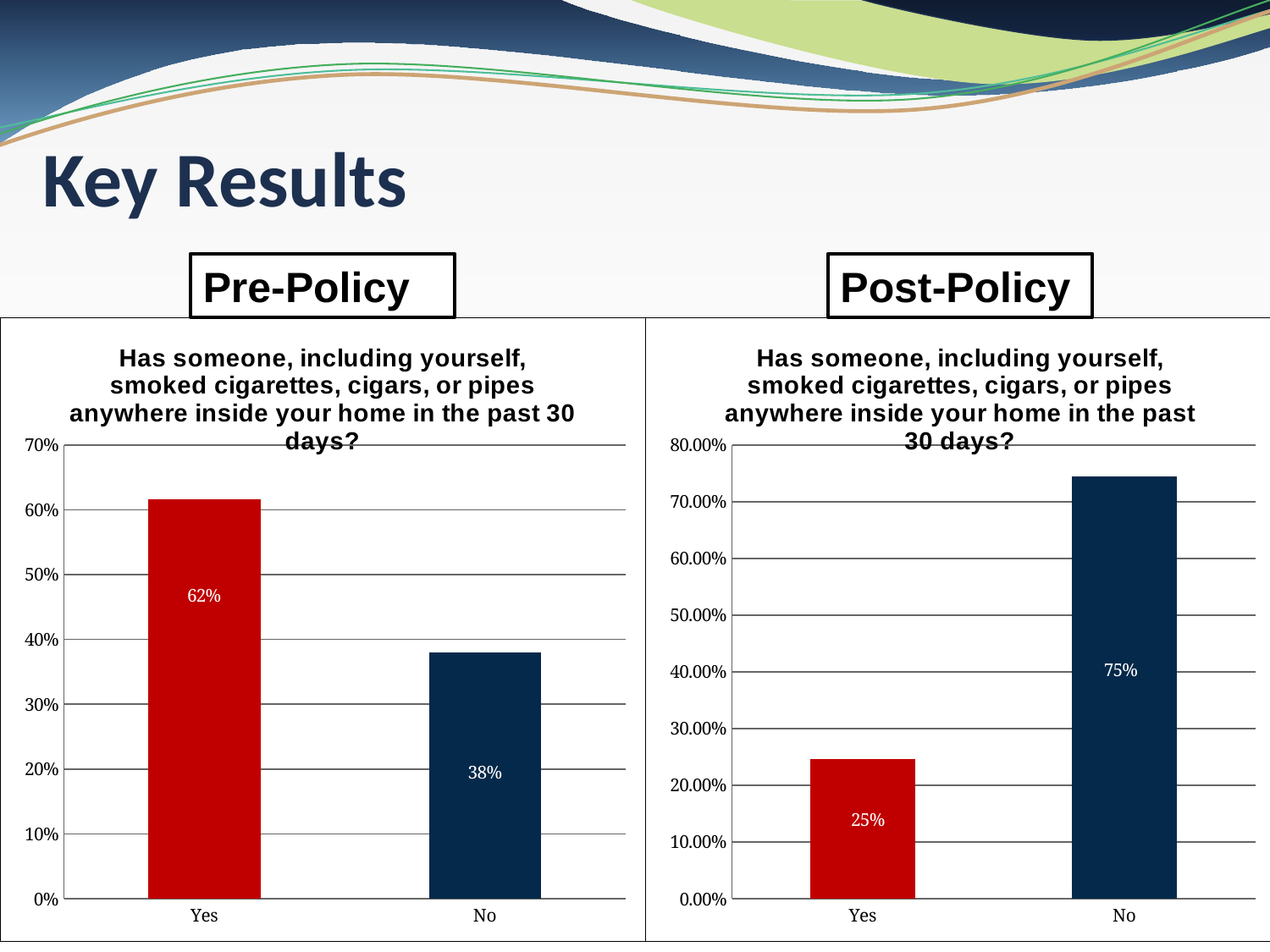
In the Post-Policy chart, which is larger, Yes or No? No In the Pre-Policy chart, is the value for No greater or less than 40%? less In the Pre-Policy chart, what is the value for Yes? 62% What kind of chart is the Pre-Policy chart? Bar chart In the Pre-Policy chart, which category has the highest value? Yes In the Pre-Policy chart, what is the difference between the Yes and No values? 24 percentage points In the Post-Policy chart, what is the value for Yes? 25% In the Post-Policy chart, what is the value for No? 75% How many categories does the Post-Policy chart show? 2 In the Post-Policy chart, which category has the lowest value? Yes In the Pre-Policy chart, what is the value for No? 38% In the Post-Policy chart, what is the difference between the No and Yes values? 50 percentage points